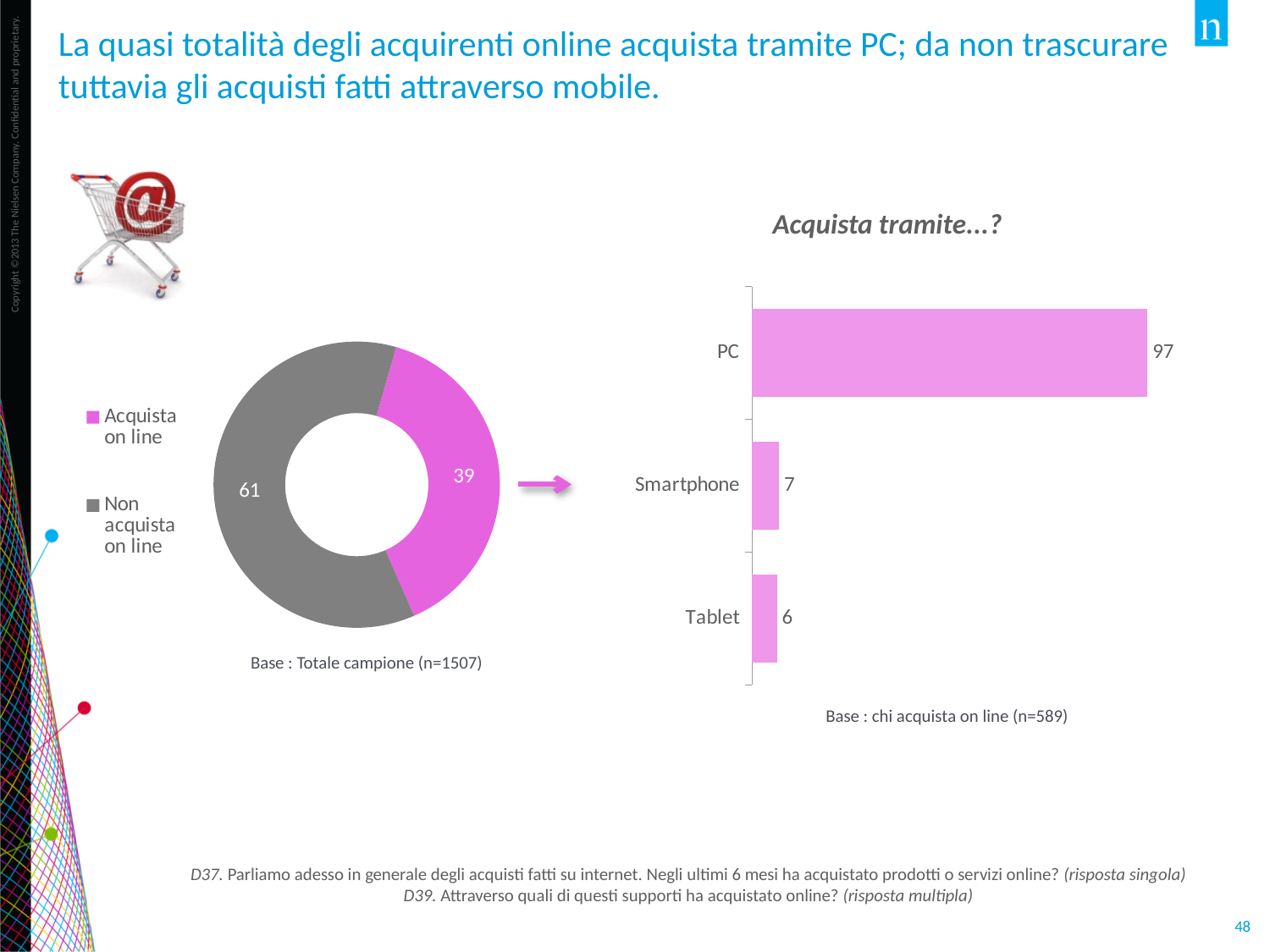
In the "Acquista tramite...?" chart, what is the difference between PC and Smartphone? 90 In the donut chart on the left, how many categories does the legend list? 2 In the "Acquista tramite...?" chart, what is the value for PC? 97 What kind of chart is the "Acquista tramite...?" chart? Bar chart In the "Acquista tramite...?" chart, what is the value for Smartphone? 7 In the "Acquista tramite...?" chart, how many categories are shown? 3 In the donut chart on the left, what is the value for "Acquista on line"? 39 In the "Acquista tramite...?" chart, which category has the lowest value? Tablet In the donut chart on the left, what is the difference between "Non acquista on line" and "Acquista on line"? 22 In the donut chart on the left, which category has the larger value? Non acquista on line In the "Acquista tramite...?" chart, what is the value for Tablet? 6 In the donut chart on the left, what is the value for "Non acquista on line"? 61